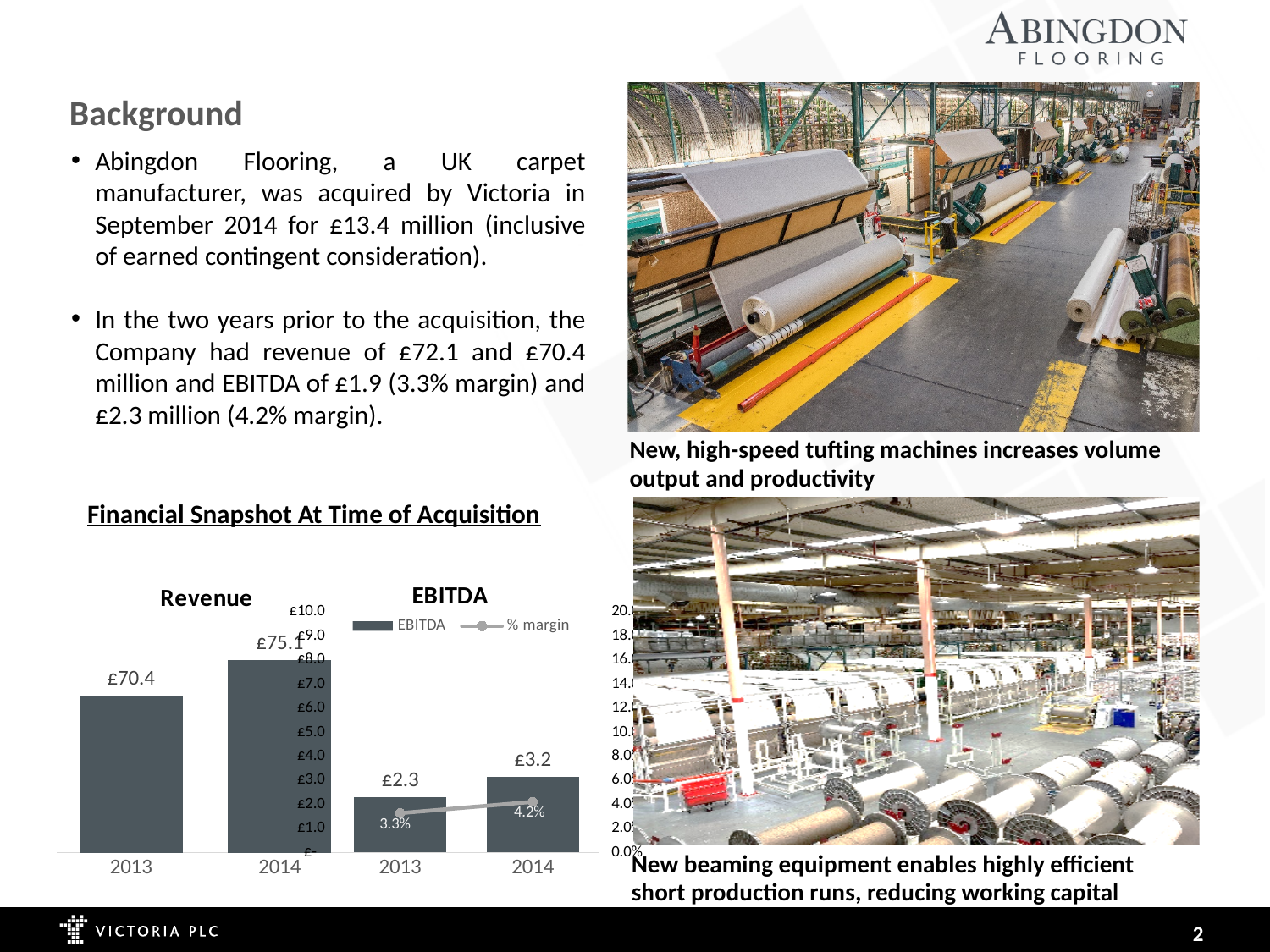
In the EBITDA chart, what is the % margin for 2014? 4.2% In the EBITDA chart, what is the EBITDA value for 2014? £3.2 In the EBITDA chart, what is the % margin for 2013? 3.3% In the Revenue chart, what is the revenue value for 2014? £75.1 In the Revenue chart, what is the revenue value for 2013? £70.4 In the Revenue chart, what is the difference between the 2014 and 2013 revenue values? £4.7 What type of chart is the Revenue chart? Bar chart In the Revenue chart, which year has the higher revenue? 2014 In the EBITDA chart, what is the difference between the 2014 and 2013 EBITDA values? £0.9 In the EBITDA chart, does the % margin rise or fall from 2013 to 2014? Rise In the EBITDA chart, which year has the lower EBITDA? 2013 In the EBITDA chart, how many series does the legend list? 2